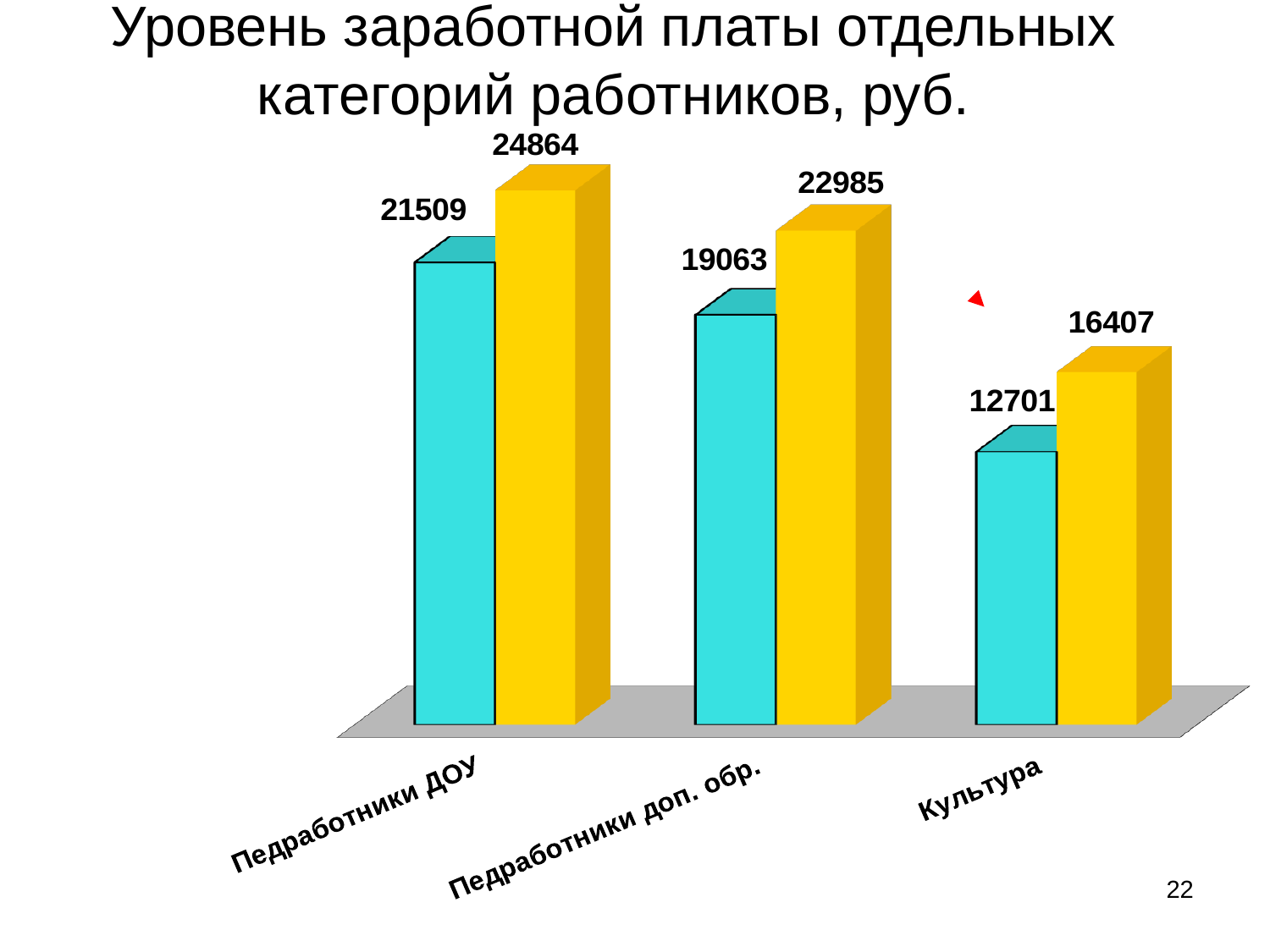
Do the yellow bar values rise or fall from left to right across the categories? fall What is the difference between the yellow and cyan bar values for Культура? 3706 How many categories are shown on the x axis? 3 What is the value of the yellow bar for Педработники ДОУ? 24864 What is the value of the cyan bar for Педработники доп. обр.? 19063 What is the value of the cyan bar for Педработники ДОУ? 21509 Which category has the highest yellow bar value? Педработники ДОУ Which category has the lowest cyan bar value? Культура What is the difference between the yellow and cyan bar values for Педработники доп. обр.? 3922 What kind of chart is shown on the slide? bar chart What is the value of the yellow bar for Культура? 16407 Which is larger: the cyan bar for Педработники ДОУ or the yellow bar for Педработники доп. обр.? the yellow bar for Педработники доп. обр.